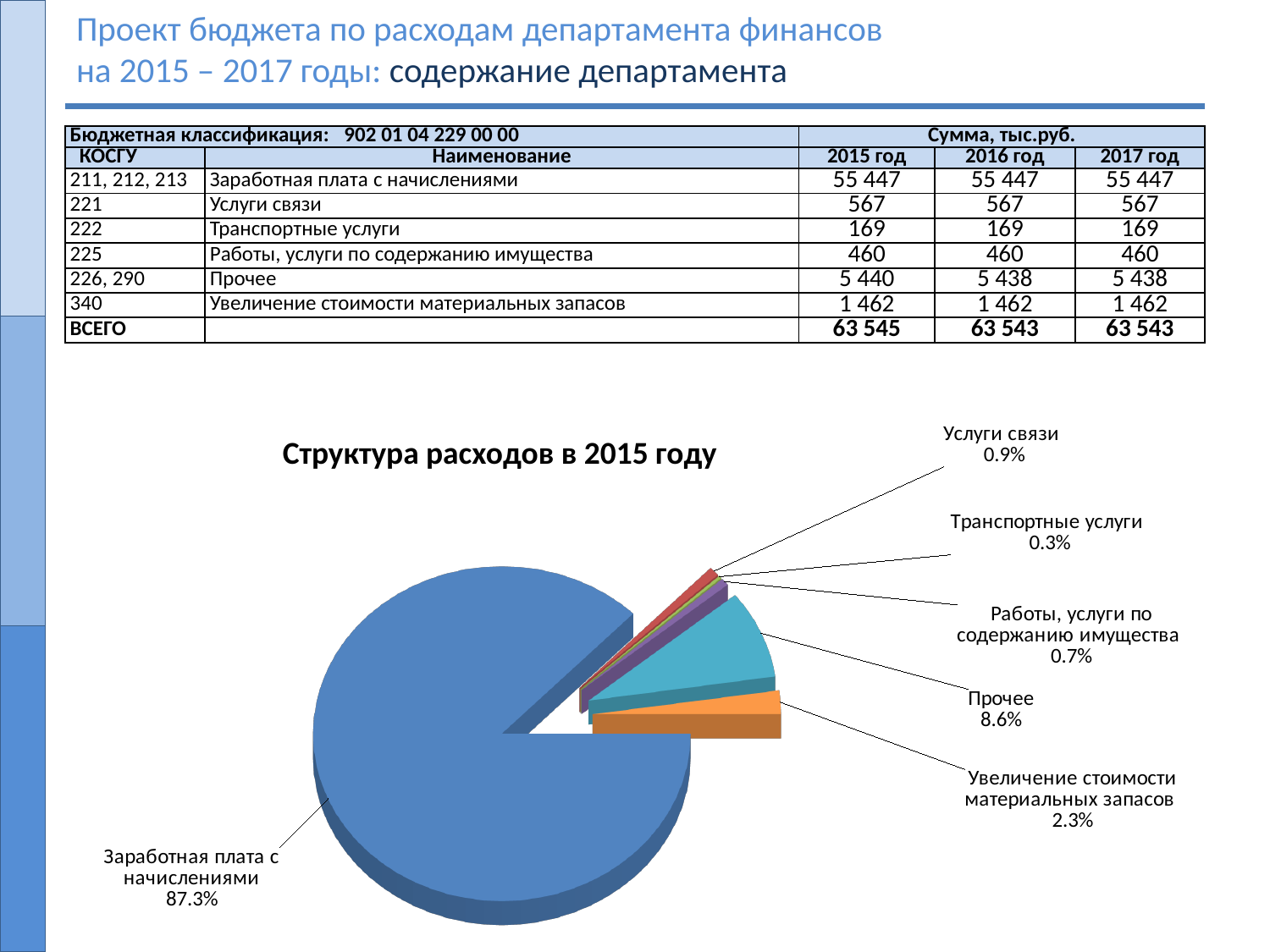
What share of the pie does "Увеличение стоимости материальных запасов" have? 2.3% What is the difference in percentage points between the shares of "Прочее" and "Увеличение стоимости материальных запасов"? 6.3 What share of the pie does "Заработная плата с начислениями" have? 87.3% What share of the pie does "Услуги связи" have? 0.9% What is the title of the chart? Структура расходов в 2015 году Which category has the largest slice of the pie? Заработная плата с начислениями What kind of chart is shown on the slide? Pie chart How many slices does the pie chart have? 6 Which category has the smallest slice of the pie? Транспортные услуги